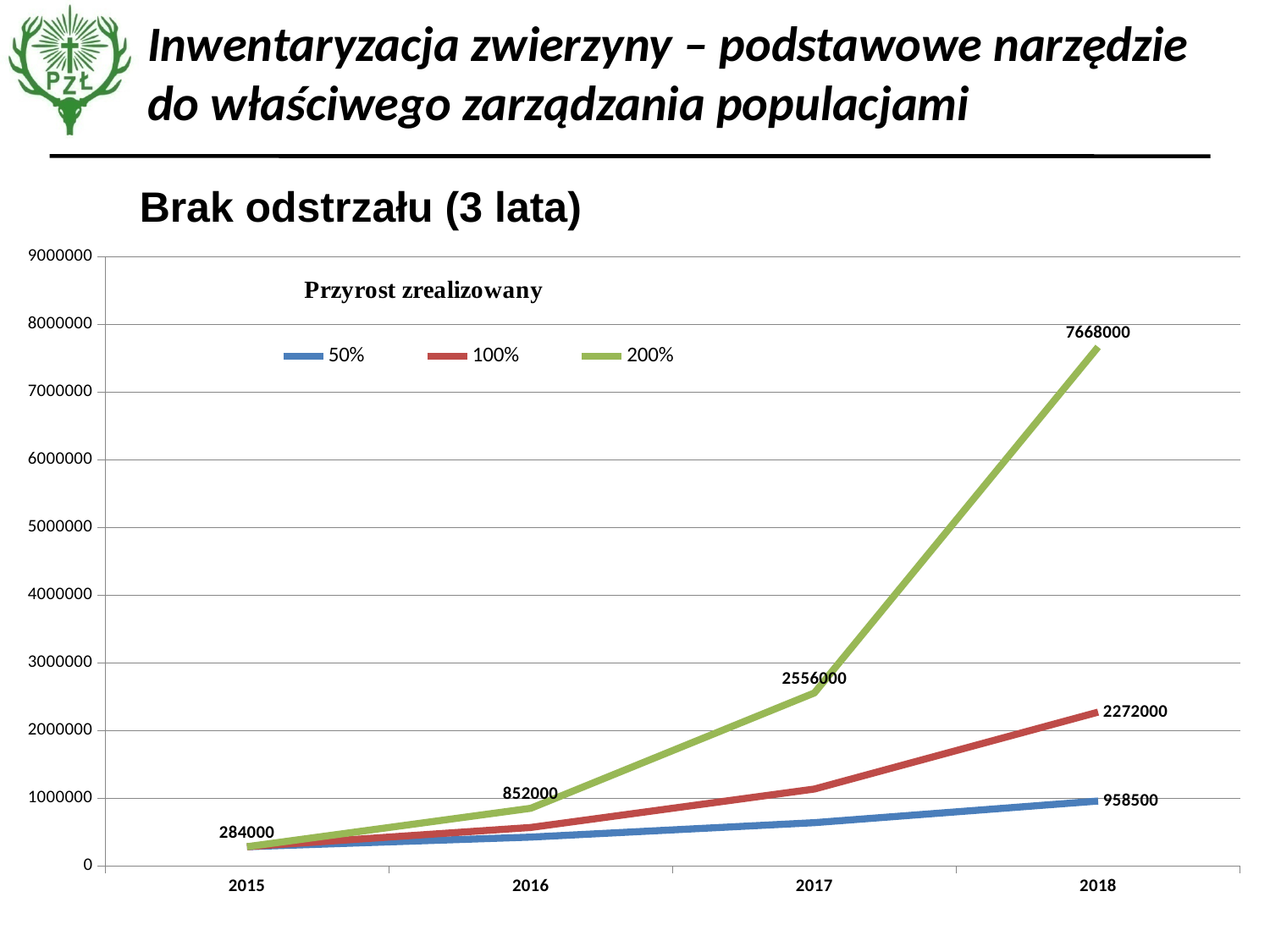
What is the difference between the 200% series and the 100% series in 2018? 5396000 What type of chart is shown on the slide? line chart How many years are shown on the x axis of the chart? 4 Which series has the highest value in 2018? 200% Does the 200% series rise or fall from 2015 to 2018? rise What are the series names listed in the chart legend? 50%, 100%, 200% How many series does the chart legend list? 3 What is the value of the 100% series in 2018? 2272000 What is the value of the 200% series in 2018? 7668000 What is the value of the 200% series in 2016? 852000 What is the value of the 200% series in 2017? 2556000 What is the value of the 50% series in 2018? 958500